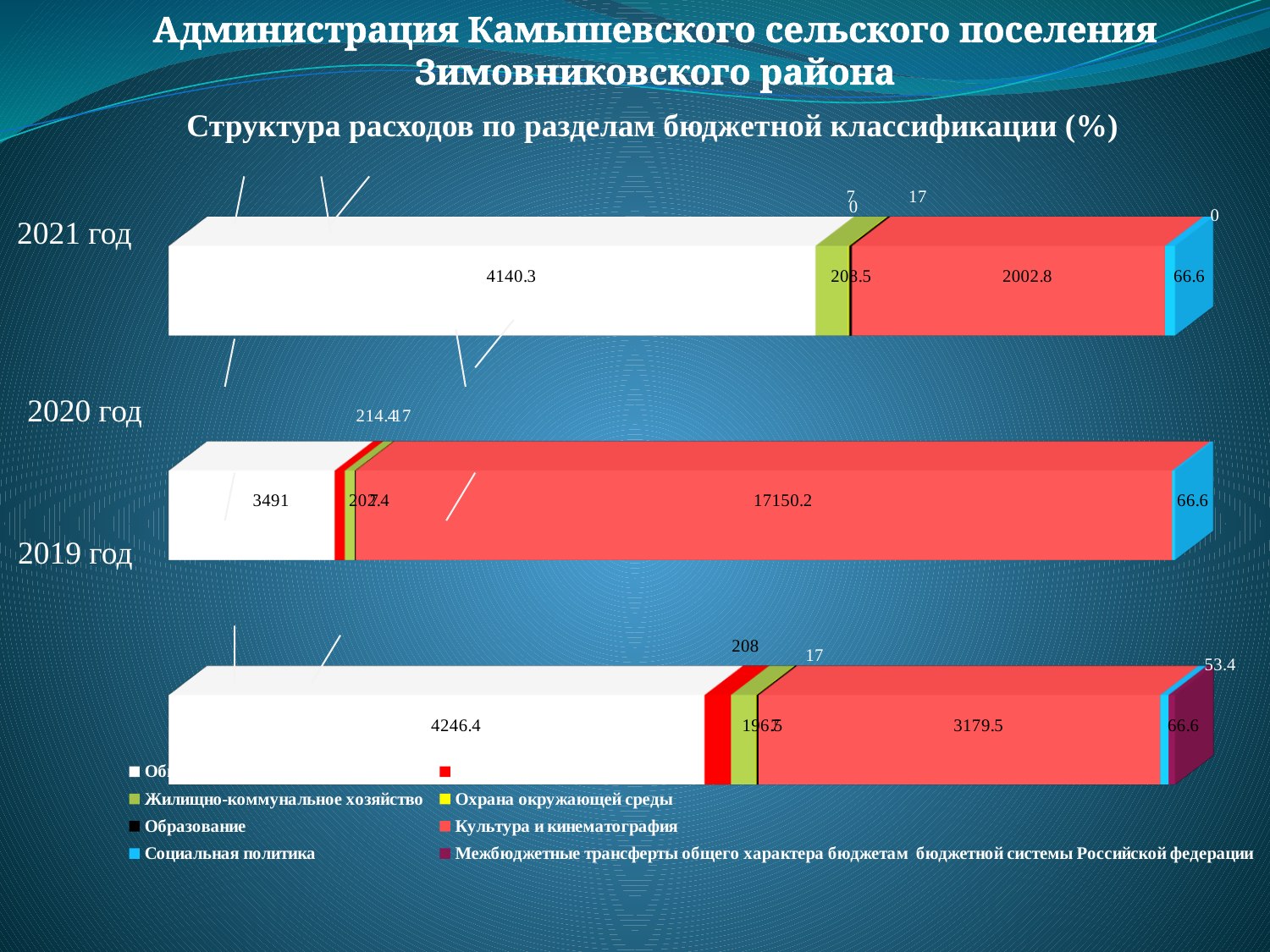
What is the title of the chart? Структура расходов по разделам бюджетной классификации (%) What is the value for Культура и кинематография in 2019? 3179.5 What is the value for Социальная политика in 2021? 66.6 What kind of chart is shown on the slide? bar chart What is the value for Межбюджетные трансферты общего характера бюджетам бюджетной системы Российской федерации in 2019? 53.4 How many years (bars) does the chart show? 3 What is the value for Культура и кинематография in 2020? 17150.2 What is the value for Культура и кинематография in 2021? 2002.8 Which is larger, the Культура и кинематография value for 2019 or for 2021? 2019 What is the difference between the Культура и кинематография values for 2019 and 2021? 1176.7 In which year is the value for Культура и кинематография the highest? 2020 How many entries does the legend list? 8